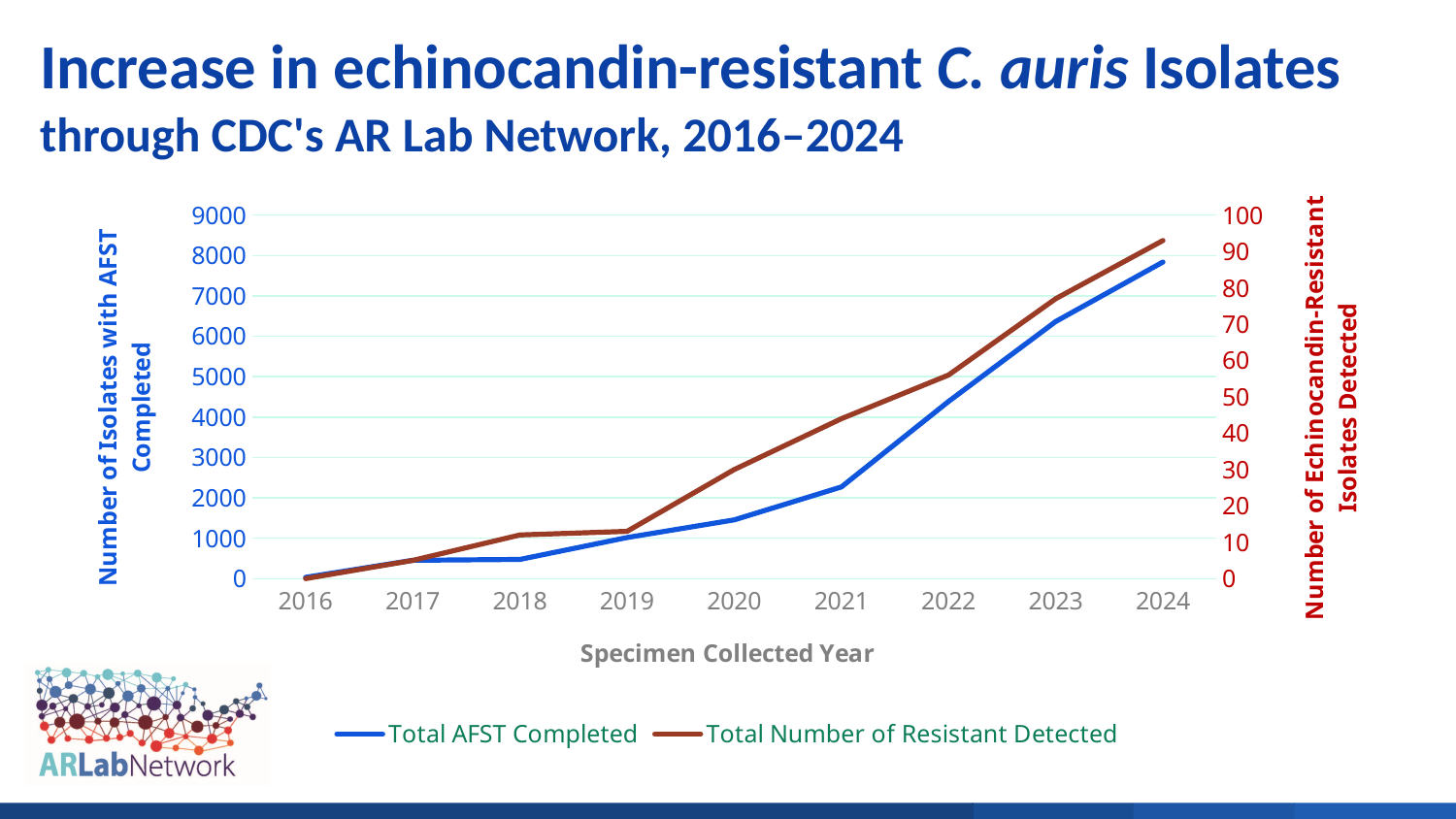
Which series is drawn in blue? Total AFST Completed In which year is the Total Number of Resistant Detected lowest? 2016 How many years are shown along the x axis? 9 Is the value for Total AFST Completed in 2024 greater or less than 7000? greater Is the value for Total Number of Resistant Detected in 2024 greater or less than 80? greater In which year is the Total AFST Completed highest? 2024 Do the values for Total AFST Completed rise or fall from 2016 to 2024? Rise What is the title of the x axis? Specimen Collected Year Is the value for Total AFST Completed in 2022 greater or less than 5000? less What kind of chart is shown on the slide? Line chart How many series does the legend list? 2